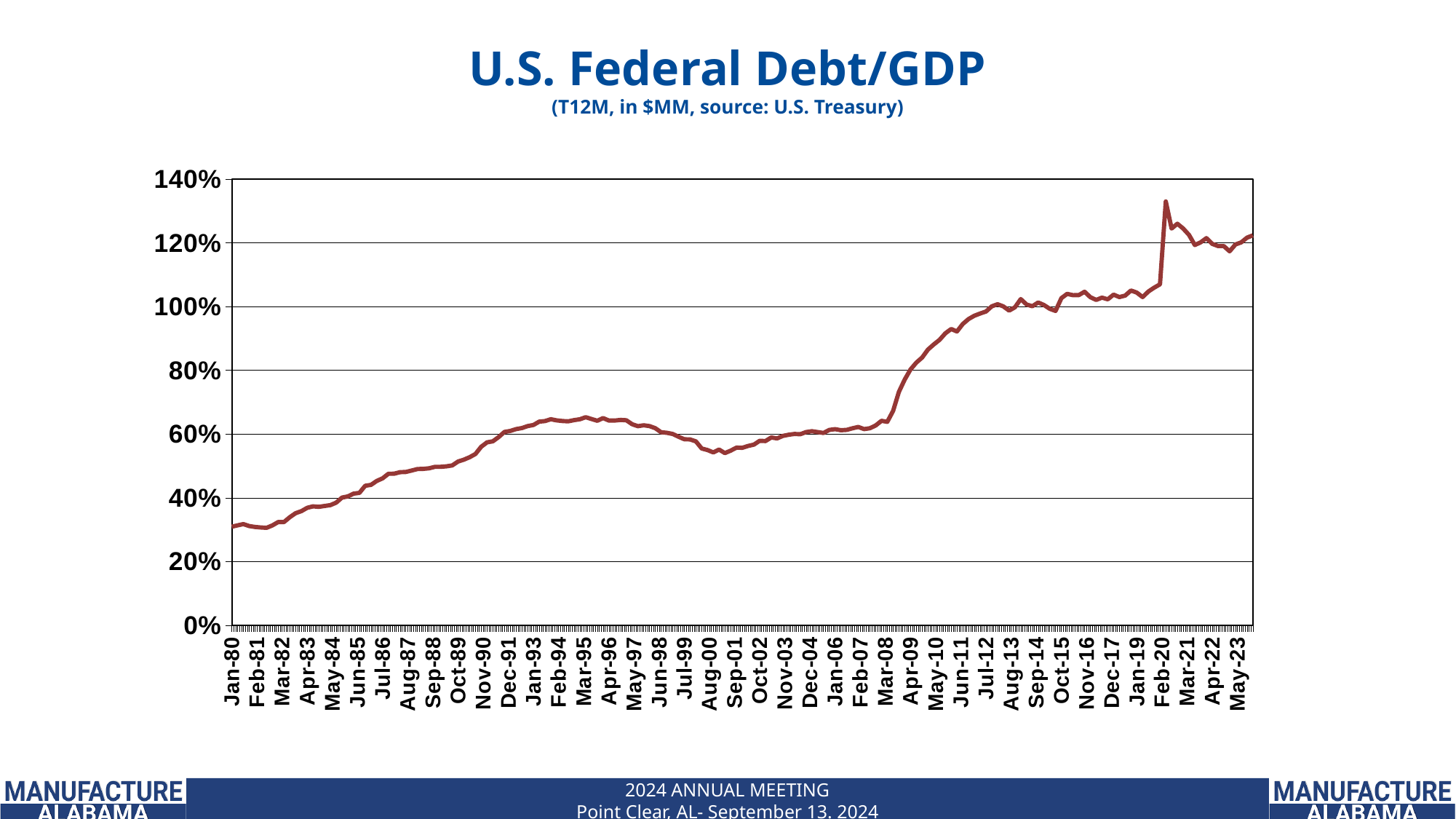
Is the value at Mar-95 greater or less than 60%? greater Overall, does the Debt/GDP line rise or fall from Jan-80 to May-23? rise According to the subtitle, what is the source of the data? U.S. Treasury How many labels are shown on the x axis? 41 Which is larger, the value at Mar-95 or the value at Aug-00? Mar-95 Is the value at Jan-80 greater or less than 40%? less Near which x-axis label does the line reach its highest value? Feb-20 Is the peak value reached shortly after Feb-20 greater or less than 120%? greater What kind of chart is shown on the slide? line chart What is the title of the chart? U.S. Federal Debt/GDP